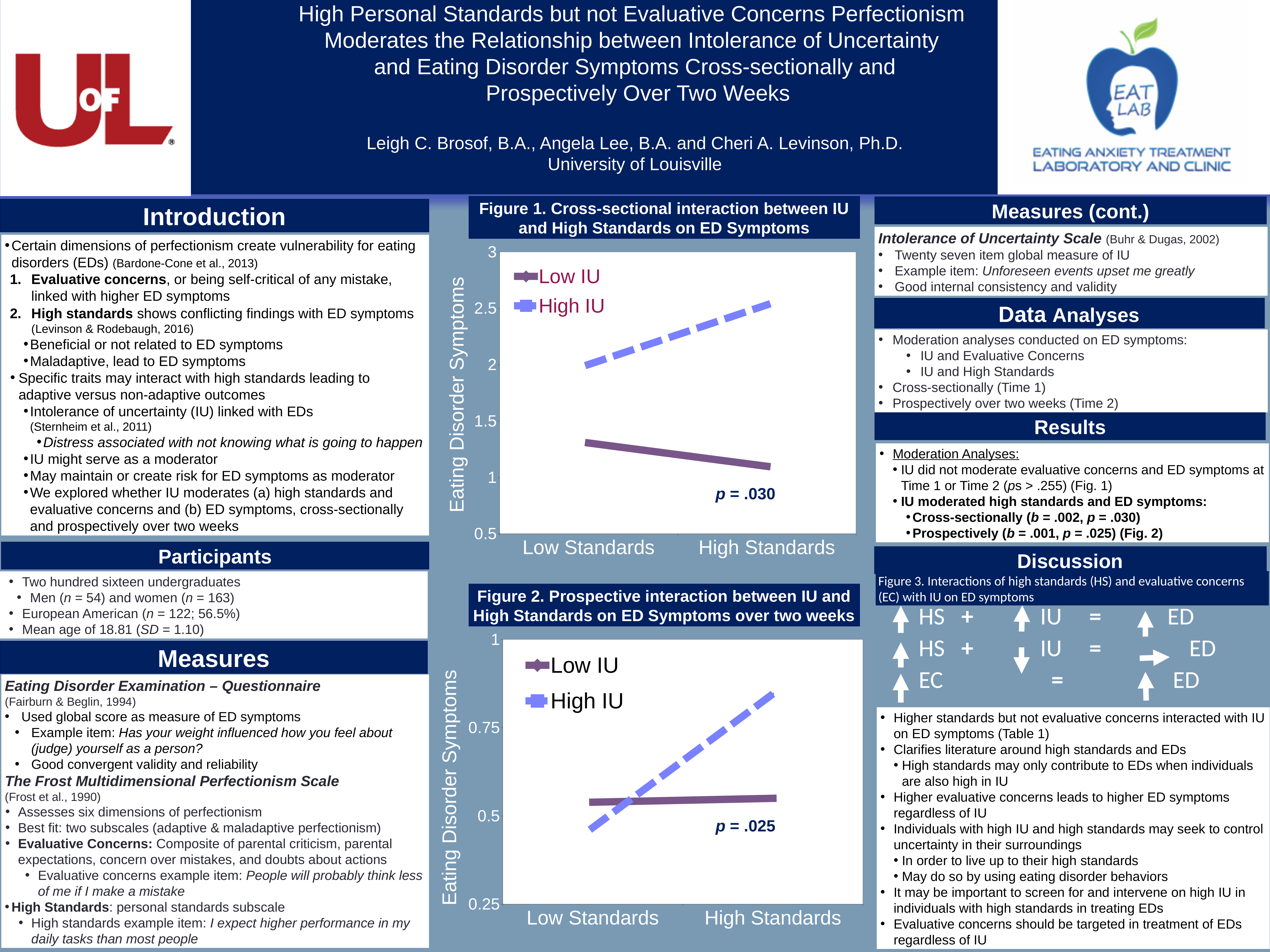
In Figure 1, does the High IU line rise or fall from Low Standards to High Standards? rise In Figure 2, is the High IU value at Low Standards greater or less than 0.5? less In Figure 1, is the High IU value at High Standards greater or less than 2? greater In Figure 1, how many series does the legend list? 2 In Figure 1, is the Low IU value at Low Standards greater or less than 1.5? less In Figure 2, does the High IU line rise or fall from Low Standards to High Standards? rise In Figure 2 (Prospective interaction between IU and High Standards on ED Symptoms over two weeks), how many categories are shown on the x axis? 2 What kind of chart is Figure 1 (Cross-sectional interaction between IU and High Standards on ED Symptoms)? line chart What p value is printed on Figure 2? p = .025 In Figure 1, does the Low IU line rise or fall from Low Standards to High Standards? fall In Figure 1, at High Standards, which series has the higher ED Symptoms value, Low IU or High IU? High IU